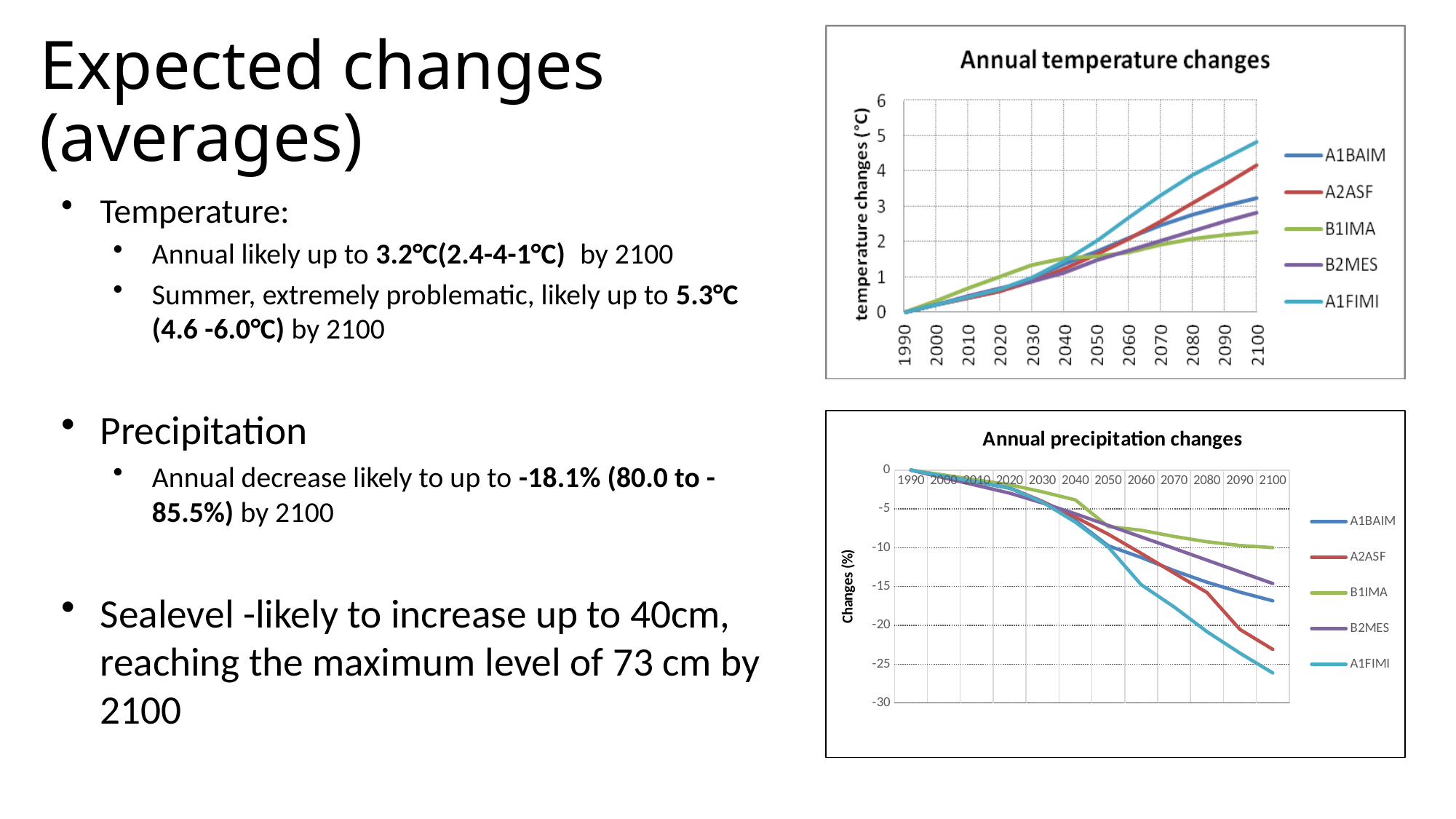
How many series does the legend of the "Annual temperature changes" chart list? 5 In the "Annual precipitation changes" chart, do the values rise or fall from 1990 to 2100? fall In the "Annual temperature changes" chart, which series has the lowest value in 2100? B1IMA In the "Annual precipitation changes" chart, which series has the highest value in 2100? B1IMA What is the y-axis label of the "Annual temperature changes" chart? temperature changes (°C) How many years are shown on the x axis of the "Annual temperature changes" chart? 12 In the "Annual temperature changes" chart, which series has the highest value in 2100? A1FIMI In the "Annual temperature changes" chart, do the values rise or fall from 1990 to 2100? rise In the "Annual temperature changes" chart, is the value for A1FIMI in 2100 greater or less than 4? greater In the "Annual precipitation changes" chart, is the value for A2ASF in 2100 greater or less than -20? less What kind of chart is the "Annual temperature changes" chart? line chart In the "Annual precipitation changes" chart, which series has the lowest value in 2100? A1FIMI